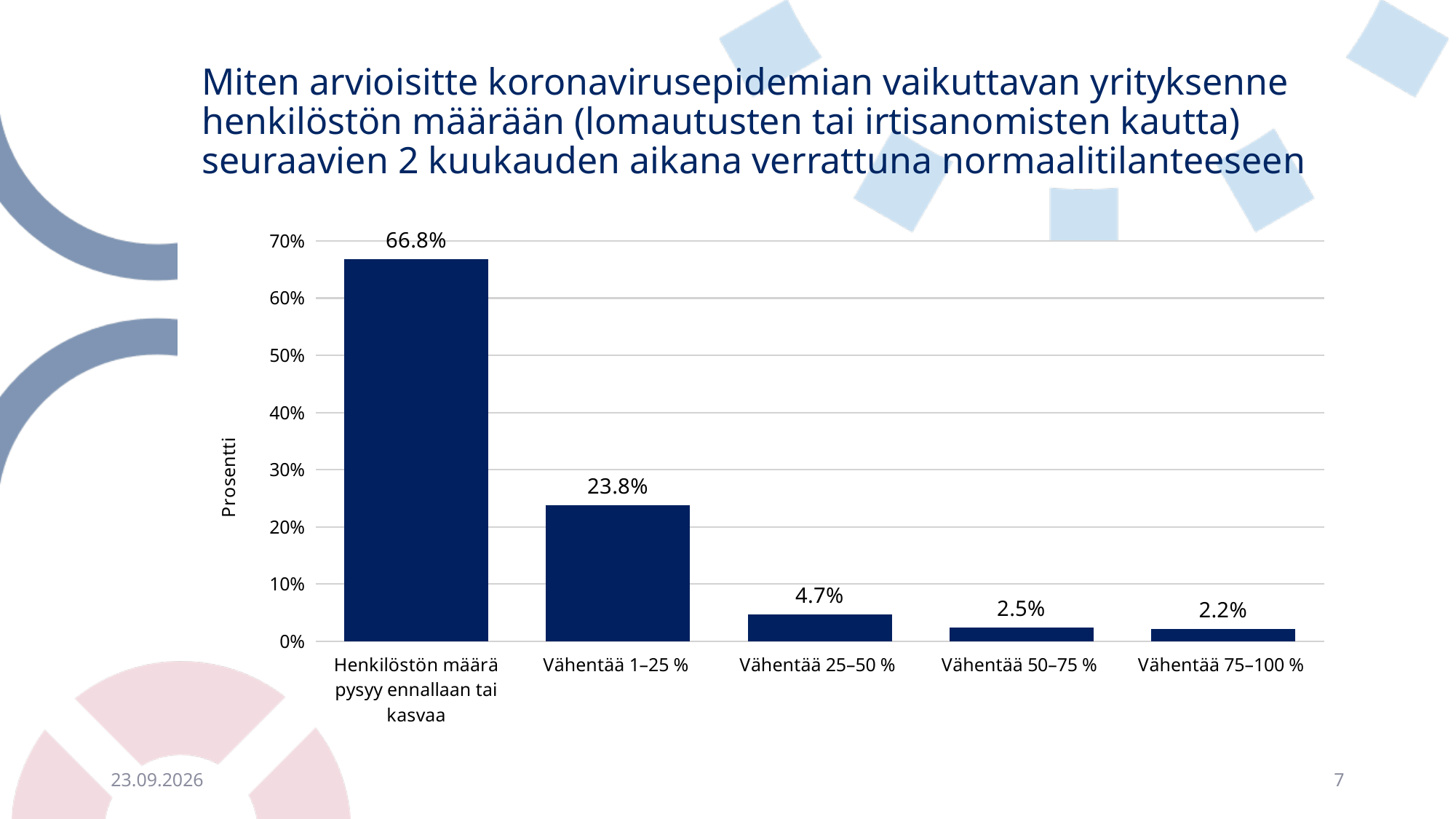
Which category has the lowest value? Vähentää 75–100 % Which category has the highest value? Henkilöstön määrä pysyy ennallaan tai kasvaa What is the difference between the values for "Henkilöstön määrä pysyy ennallaan tai kasvaa" and "Vähentää 1–25 %"? 43.0% What is the label of the vertical axis? Prosentti How many categories are shown on the x axis? 5 What is the value for "Vähentää 1–25 %"? 23.8% What kind of chart is shown on the slide? Bar chart What is the value for "Vähentää 75–100 %"? 2.2% What is the value for "Henkilöstön määrä pysyy ennallaan tai kasvaa"? 66.8% Which is larger, the value for "Vähentää 25–50 %" or "Vähentää 50–75 %"? Vähentää 25–50 % What is the value for "Vähentää 25–50 %"? 4.7% Is the value for "Vähentää 1–25 %" greater or less than 20%? greater